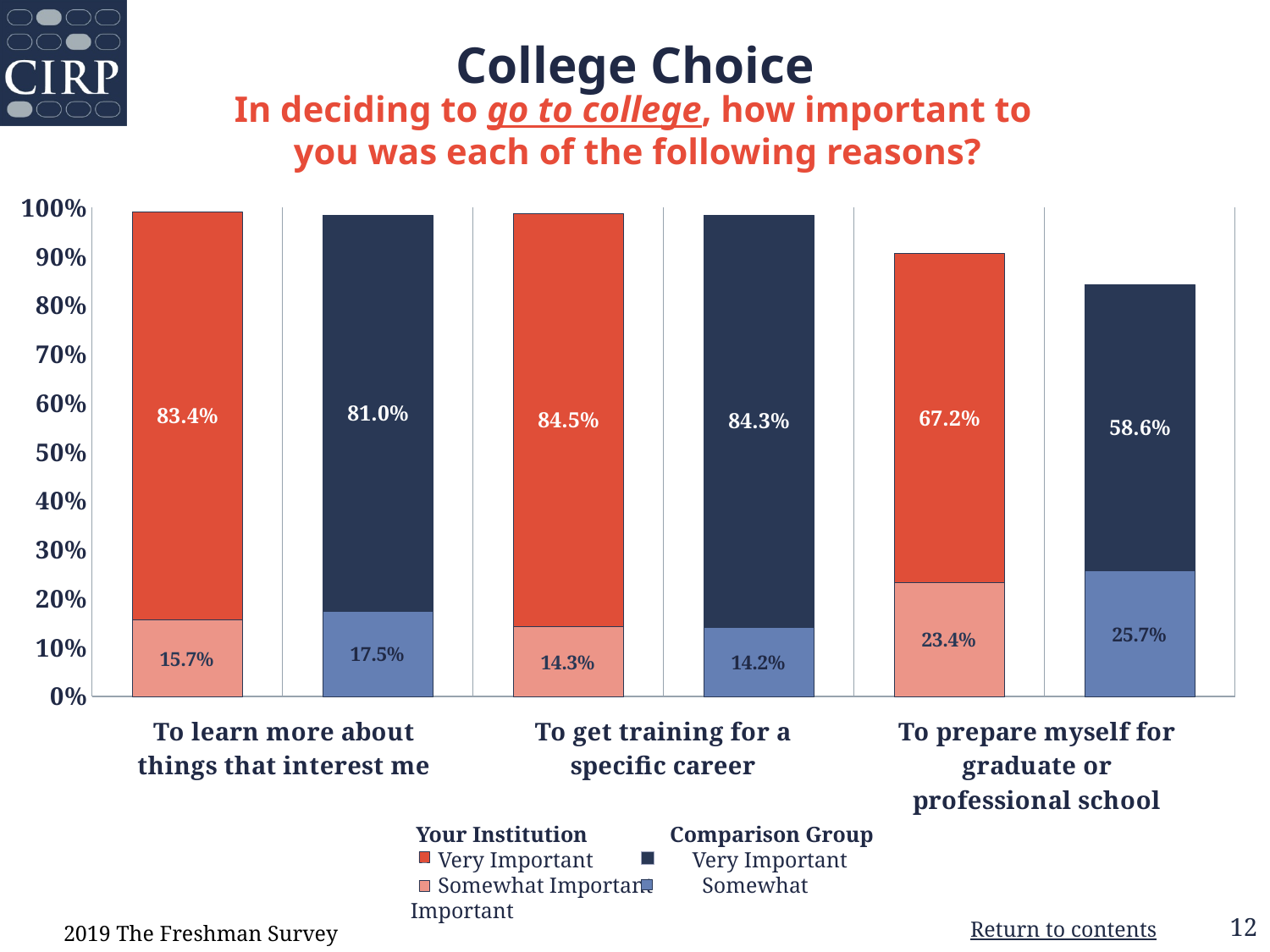
For "To learn more about things that interest me", which group has the larger Very Important percentage, Your Institution or the Comparison Group? Your Institution What is the difference between Your Institution and the Comparison Group in the Very Important percentage for "To prepare myself for graduate or professional school"? 8.6% How many series does the chart legend list? 4 What is the combined Very Important and Somewhat Important percentage for Your Institution for "To prepare myself for graduate or professional school"? 90.6% Which reason has the highest Very Important percentage for Your Institution? To get training for a specific career What kind of chart is shown on the slide? Stacked bar chart What percentage of the Comparison Group rated "To prepare myself for graduate or professional school" as Very Important? 58.6% What percentage of Your Institution students rated "To learn more about things that interest me" as Very Important? 83.4% What percentage of Your Institution students rated "To get training for a specific career" as Somewhat Important? 14.3% Which reason has the lowest Very Important percentage for the Comparison Group? To prepare myself for graduate or professional school What percentage of the Comparison Group rated "To learn more about things that interest me" as Somewhat Important? 17.5% How many reasons (categories) are shown on the x axis of the chart? 3